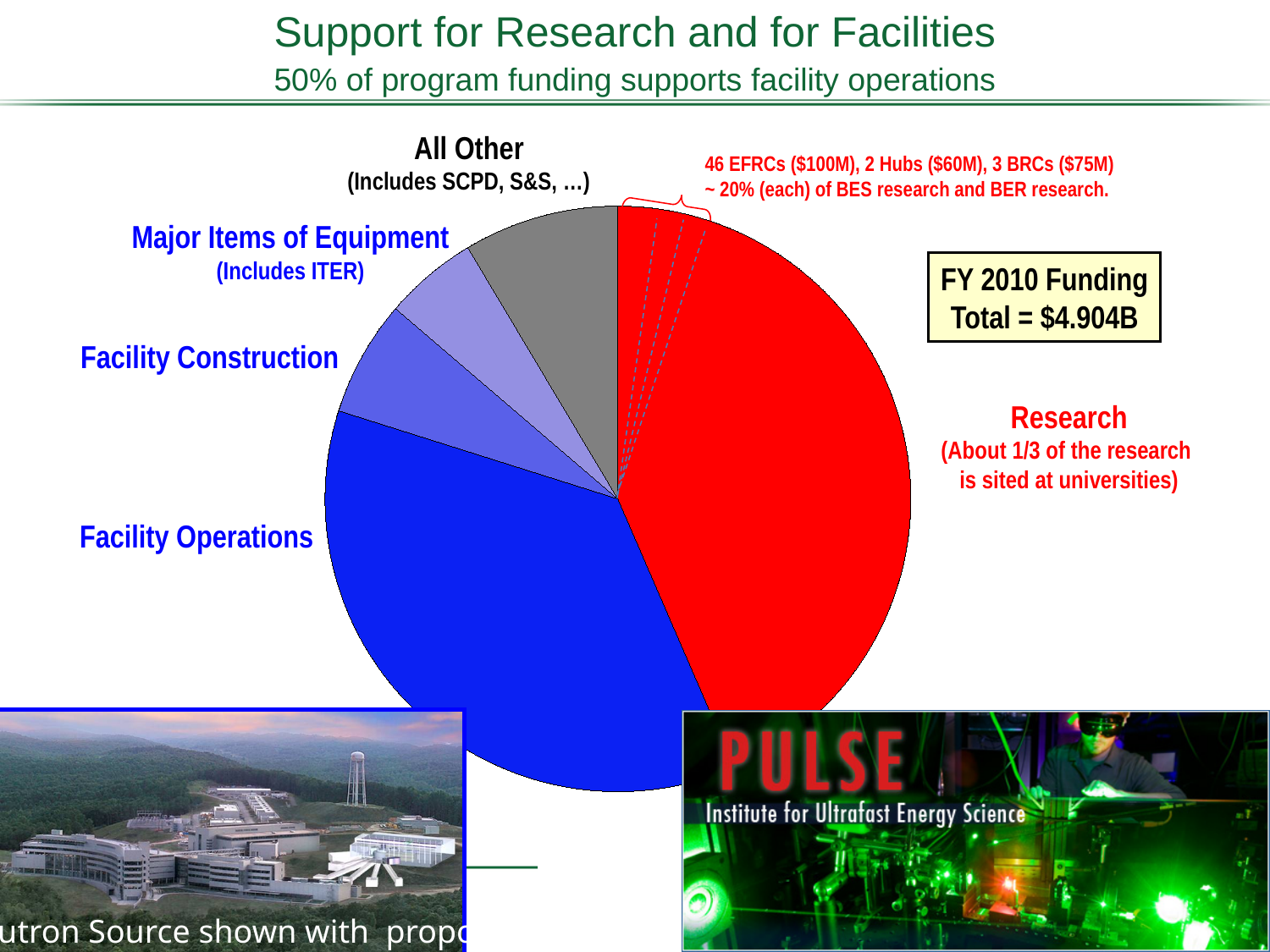
Which slice is larger, Facility Construction or All Other? All Other Which slice is larger, Research or Facility Operations? Research What is the title of the slide containing the pie chart? Support for Research and for Facilities Which category has the largest slice of the pie chart? Research What colour is the Research slice of the pie chart? red Which category has the smallest slice of the pie chart? Major Items of Equipment How many slices does the pie chart have? 5 What is the FY 2010 funding total shown next to the pie chart? $4.904B What kind of chart is shown on the slide? pie chart Which slice is larger, Facility Operations or Facility Construction? Facility Operations